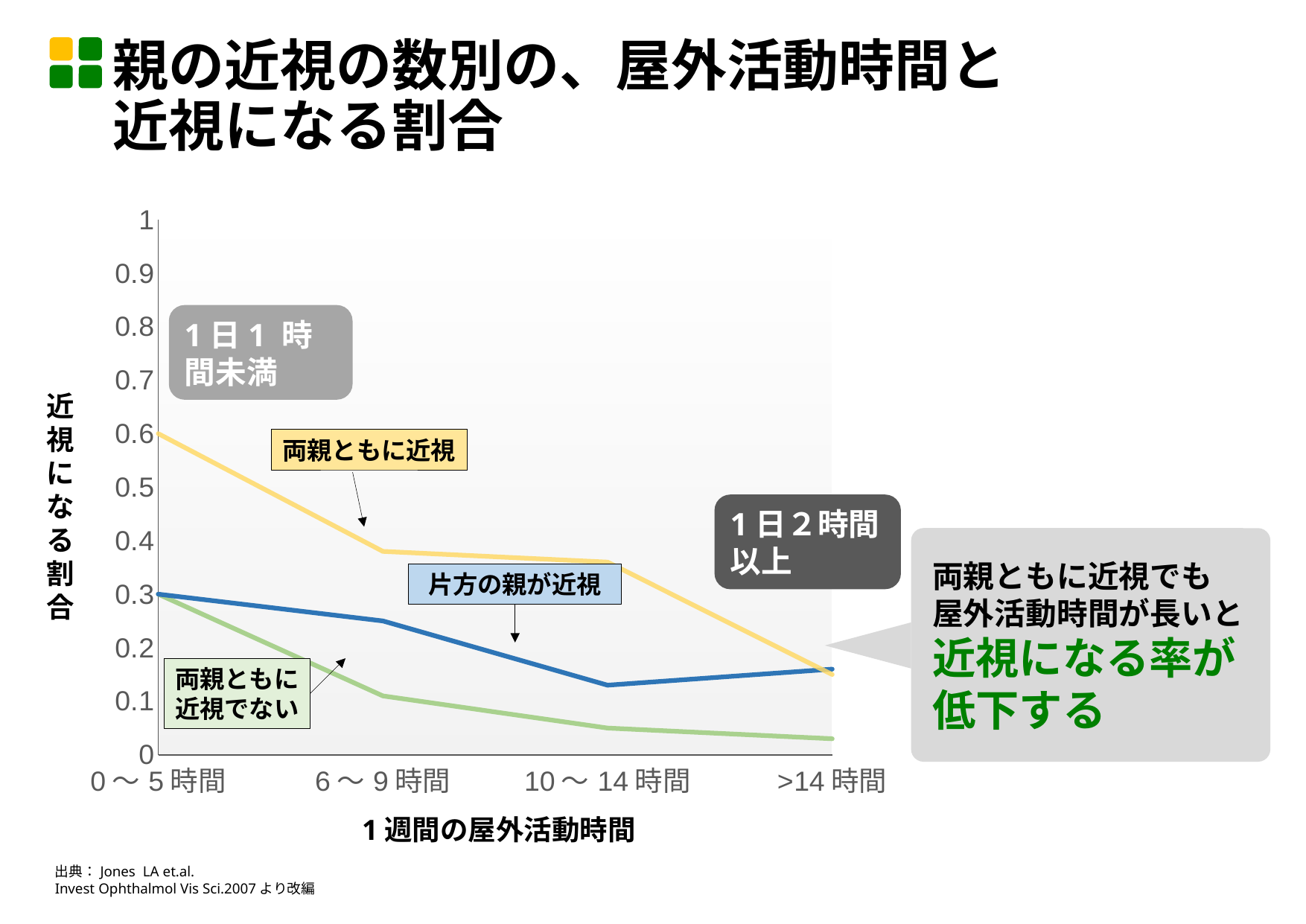
Is the value for 両親ともに近視 at 6～9時間 greater or less than 0.3? greater At 6～9時間, which is larger: the value for 両親ともに近視 or for 両親ともに近視でない? 両親ともに近視 Is the value for 両親ともに近視 at >14時間 greater or less than 0.2? less Is the value for 両親ともに近視でない at 10～14時間 greater or less than 0.1? less What is the title of the x axis of the chart? 1週間の屋外活動時間 How many categories are shown on the x axis of the chart? 4 What kind of chart is shown on the slide? line chart How many series (lines) are plotted in the chart? 3 Does the 両親ともに近視 line rise or fall as outdoor activity time increases along the x axis? fall Which series has the lowest value at 6～9時間? 両親ともに近視でない Which series has the highest value at 0～5時間? 両親ともに近視